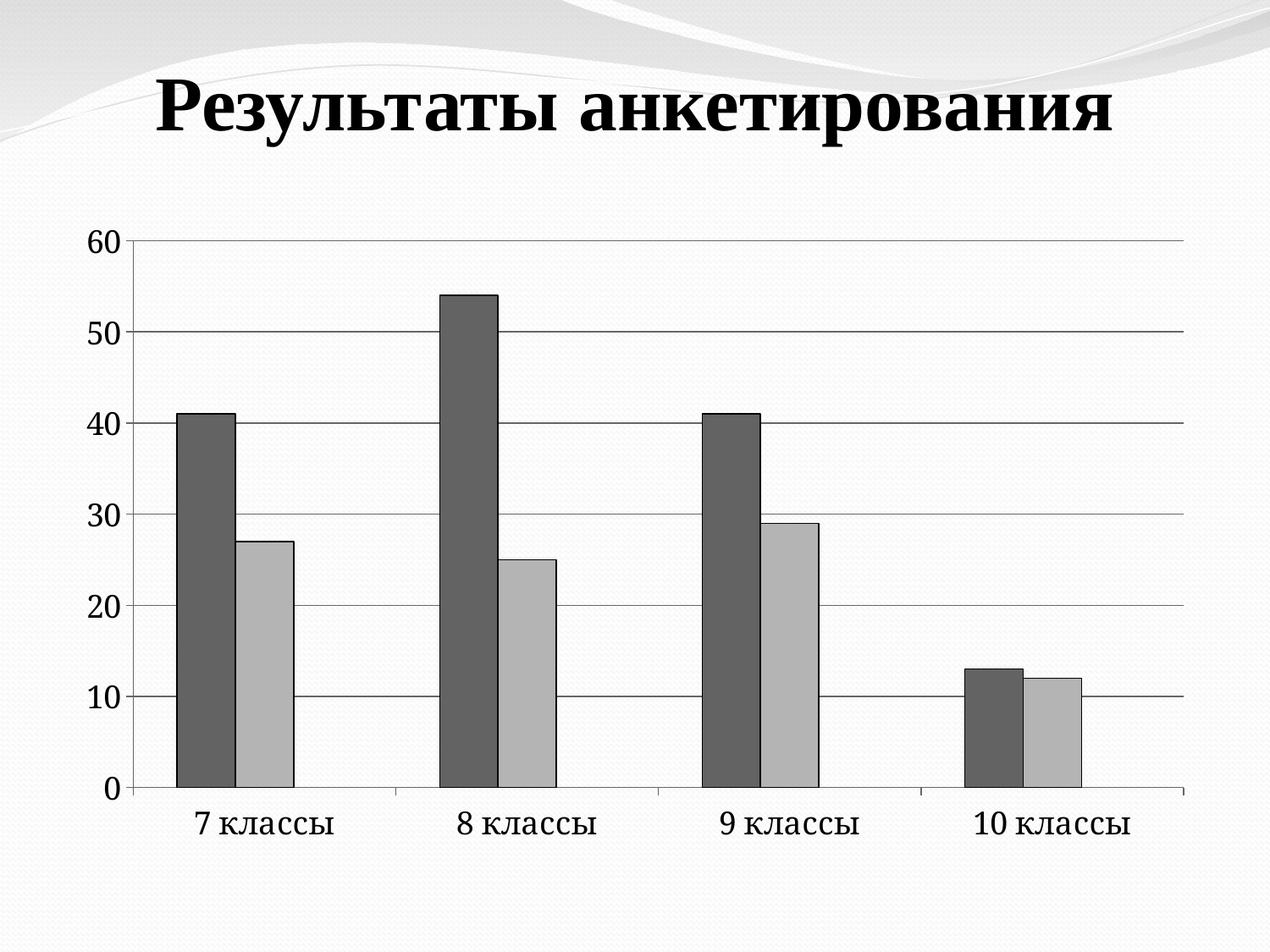
What is the title of the chart? Результаты анкетирования Is the light grey bar for 7 классы greater or less than 30? less Is the dark grey bar for 8 классы greater or less than 50? greater Which category has the shortest dark grey bar? 10 классы Is the light grey bar for 9 классы greater or less than 20? greater Which category has the tallest dark grey bar? 8 классы How many categories are shown on the x axis? 4 What kind of chart is shown on the slide? Bar chart Which category has the shortest light grey bar? 10 классы How many bars are plotted for each category? 2 Which is larger, the dark grey bar for 8 классы or the dark grey bar for 9 классы? 8 классы